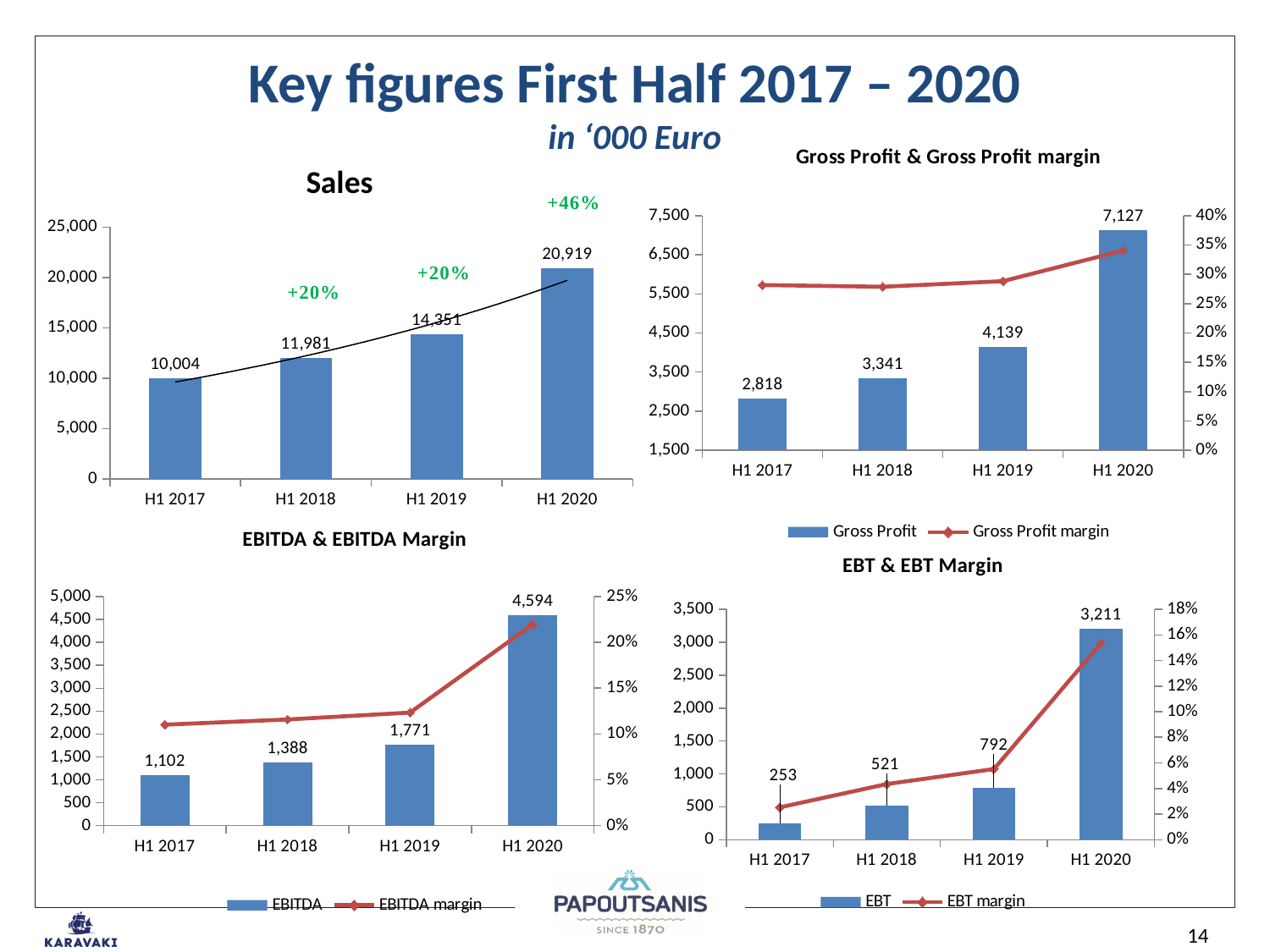
In the Gross Profit & Gross Profit margin chart, is the Gross Profit margin for H1 2020 greater or less than 30%? greater In the Sales chart, do the values rise or fall from H1 2017 to H1 2020? rise In the Sales chart, what growth percentage is shown between H1 2019 and H1 2020? +46% In the Sales chart, what is the value for H1 2020? 20,919 In the EBT & EBT Margin chart, what is the EBT for H1 2019? 792 In the Sales chart, how many periods are shown on the x axis? 4 In the Gross Profit & Gross Profit margin chart, which period has the highest Gross Profit? H1 2020 In the Gross Profit & Gross Profit margin chart, what is the Gross Profit for H1 2018? 3,341 In the EBITDA & EBITDA Margin chart, how many series does the legend list? 2 In the EBITDA & EBITDA Margin chart, what is the EBITDA for H1 2017? 1,102 In the EBT & EBT Margin chart, what is the difference between the EBT for H1 2020 and H1 2017? 2,958 In the Sales chart, what is the difference between the H1 2020 and H1 2019 values? 6,568